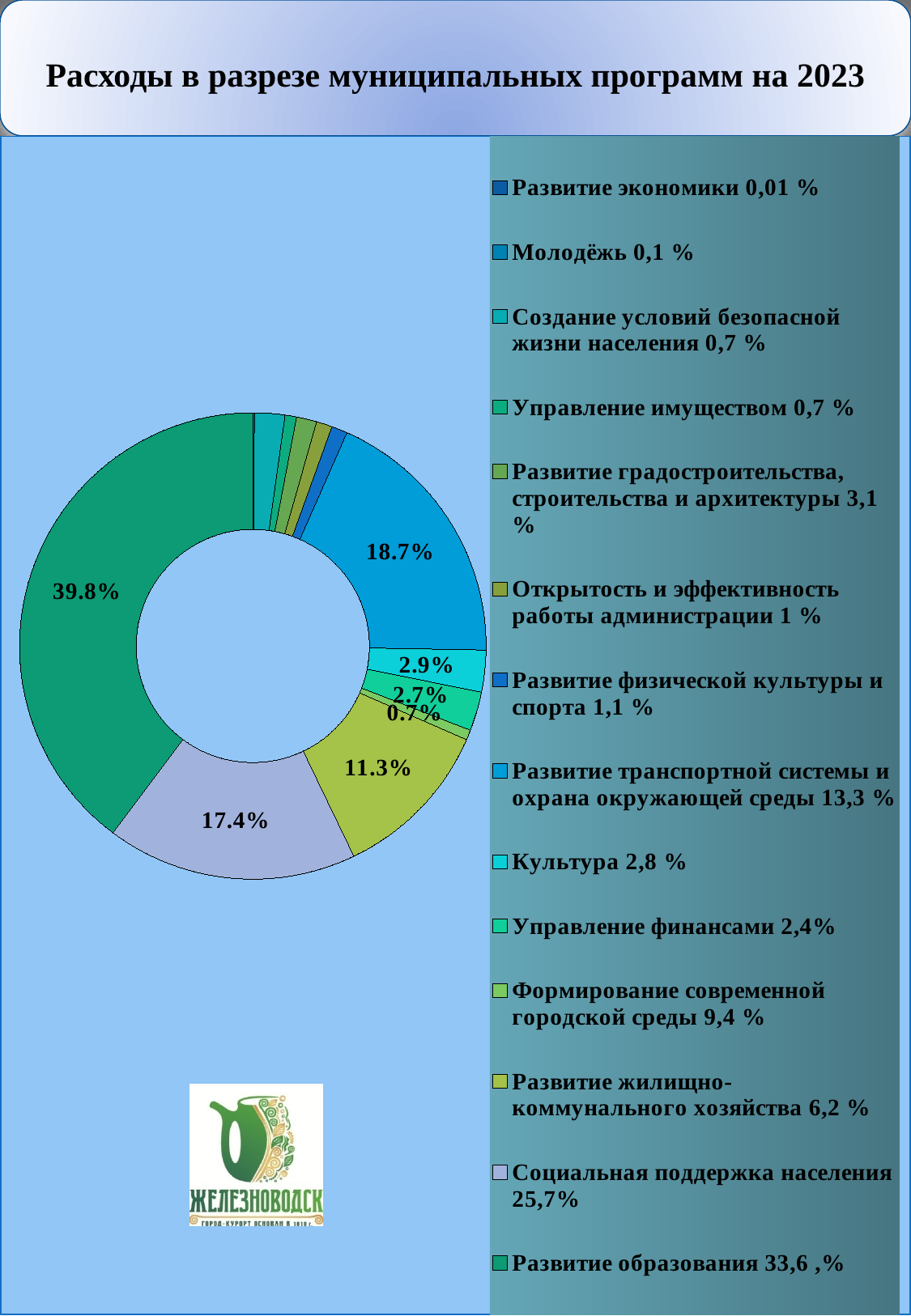
What data label is printed on the lavender slice (Социальная поддержка населения)? 17.4% Which category corresponds to the largest slice of the chart (dark green, labelled 39.8%)? Развитие образования According to the legend text, what percentage is given for Культура? 2,8 % What is the difference between the slices labelled 39.8% and 17.4%? 22.4 percentage points What is the title of the slide? Расходы в разрезе муниципальных программ на 2023 What is the difference between the slices labelled 18.7% and 11.3%? 7.4 percentage points Which slice is larger: the one labelled 18.7% or the one labelled 17.4%? the one labelled 18.7% What data label is printed on the blue slice (Развитие транспортной системы и охрана окружающей среды)? 18.7% How many categories does the legend of the chart list? 14 What is the largest data label printed on the chart? 39.8% What kind of chart is shown on the slide? doughnut (pie) chart What data label is printed on the olive slice (Развитие жилищно-коммунального хозяйства)? 11.3%